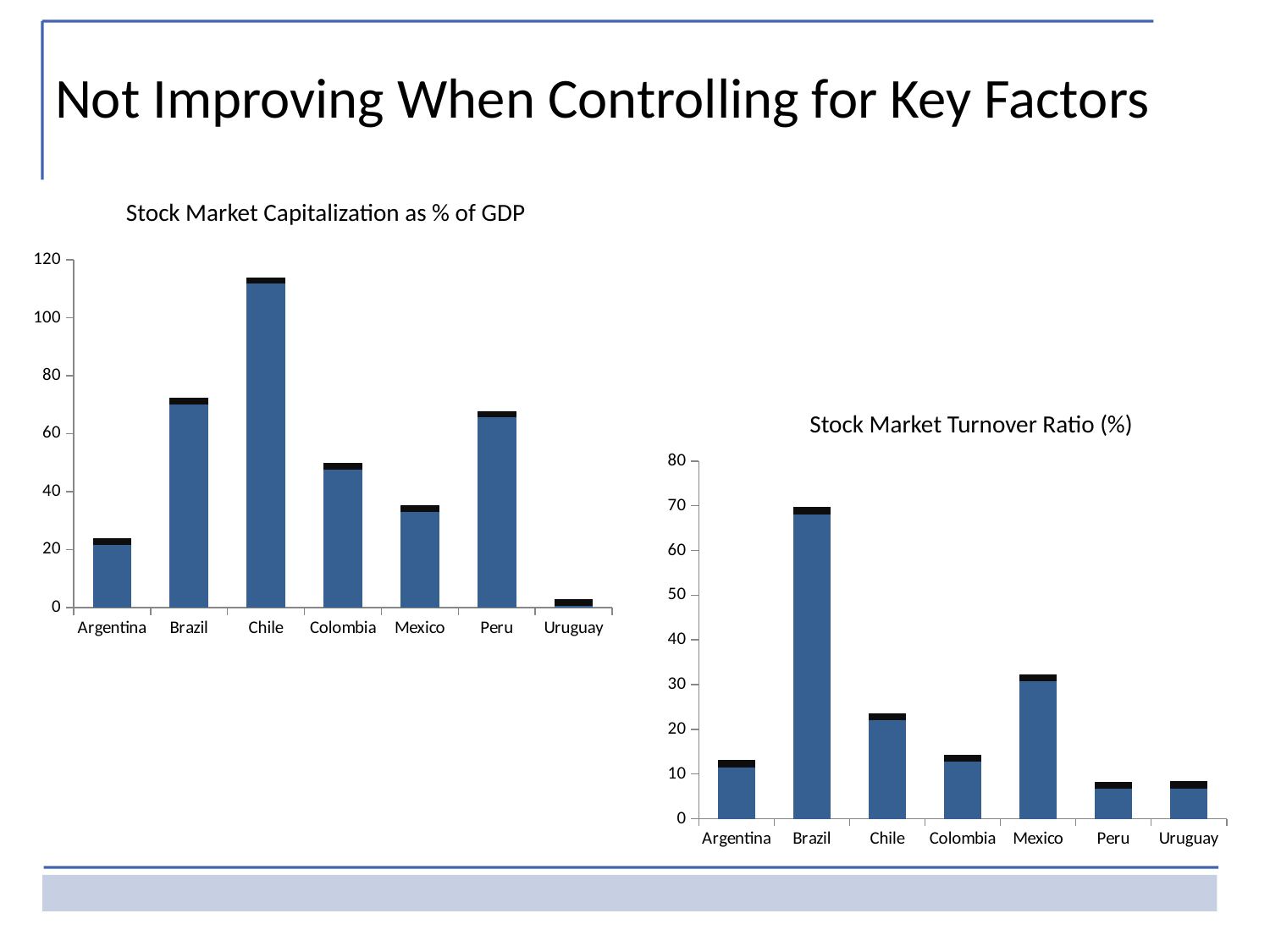
In the Stock Market Capitalization as % of GDP chart, which is larger, Brazil or Peru? Brazil In the Stock Market Turnover Ratio (%) chart, which is larger, Chile or Colombia? Chile What kind of chart is the Stock Market Capitalization as % of GDP chart? bar chart What is the title of the chart on the right side of the slide? Stock Market Turnover Ratio (%) In the Stock Market Capitalization as % of GDP chart, is the value for Uruguay greater or less than 20? less In the Stock Market Capitalization as % of GDP chart, is the value for Chile greater or less than 100? greater How many countries are shown in the Stock Market Turnover Ratio (%) chart? 7 In the Stock Market Capitalization as % of GDP chart, which country has the highest value? Chile In the Stock Market Turnover Ratio (%) chart, is the value for Peru greater or less than 10? less In the Stock Market Capitalization as % of GDP chart, which country has the lowest value? Uruguay In the Stock Market Turnover Ratio (%) chart, which country has the highest value? Brazil